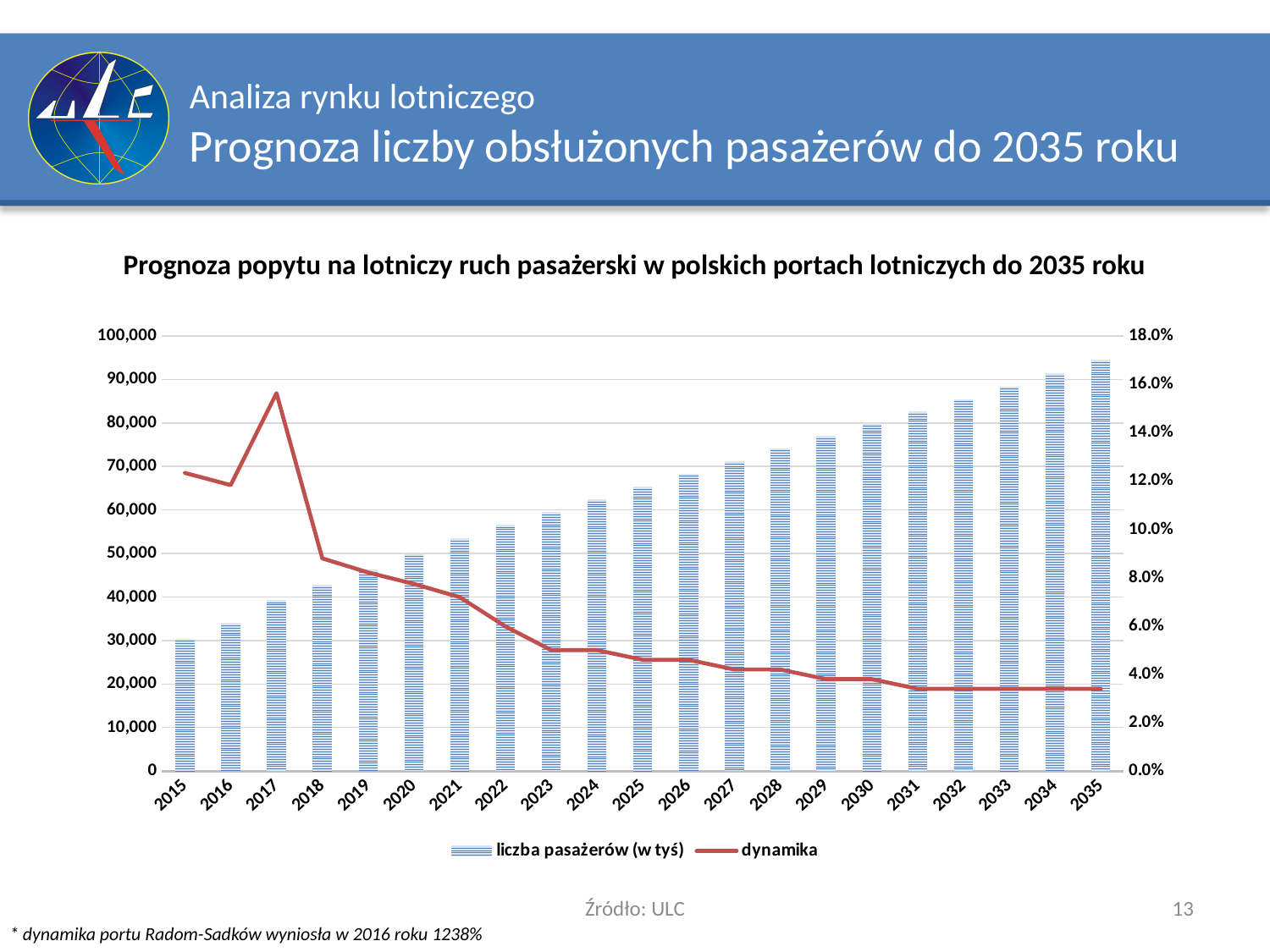
Is the dynamika value for 2025 greater or less than 6.0%? less Which year has the highest bar for liczba pasażerów (w tyś)? 2035 Is the liczba pasażerów (w tyś) value for 2020 greater or less than 40,000? greater In which year does the dynamika line reach its highest point? 2017 Do the liczba pasażerów (w tyś) bars rise or fall from 2015 to 2035? rise How many years are shown on the x axis of the chart? 21 What kind of chart is shown on the slide? A bar chart combined with a line Is the dynamika value for 2017 greater or less than 14.0%? greater How many series does the chart legend list? 2 Which year has the lowest bar for liczba pasażerów (w tyś)? 2015 Which year has the larger liczba pasażerów (w tyś) bar, 2018 or 2022? 2022